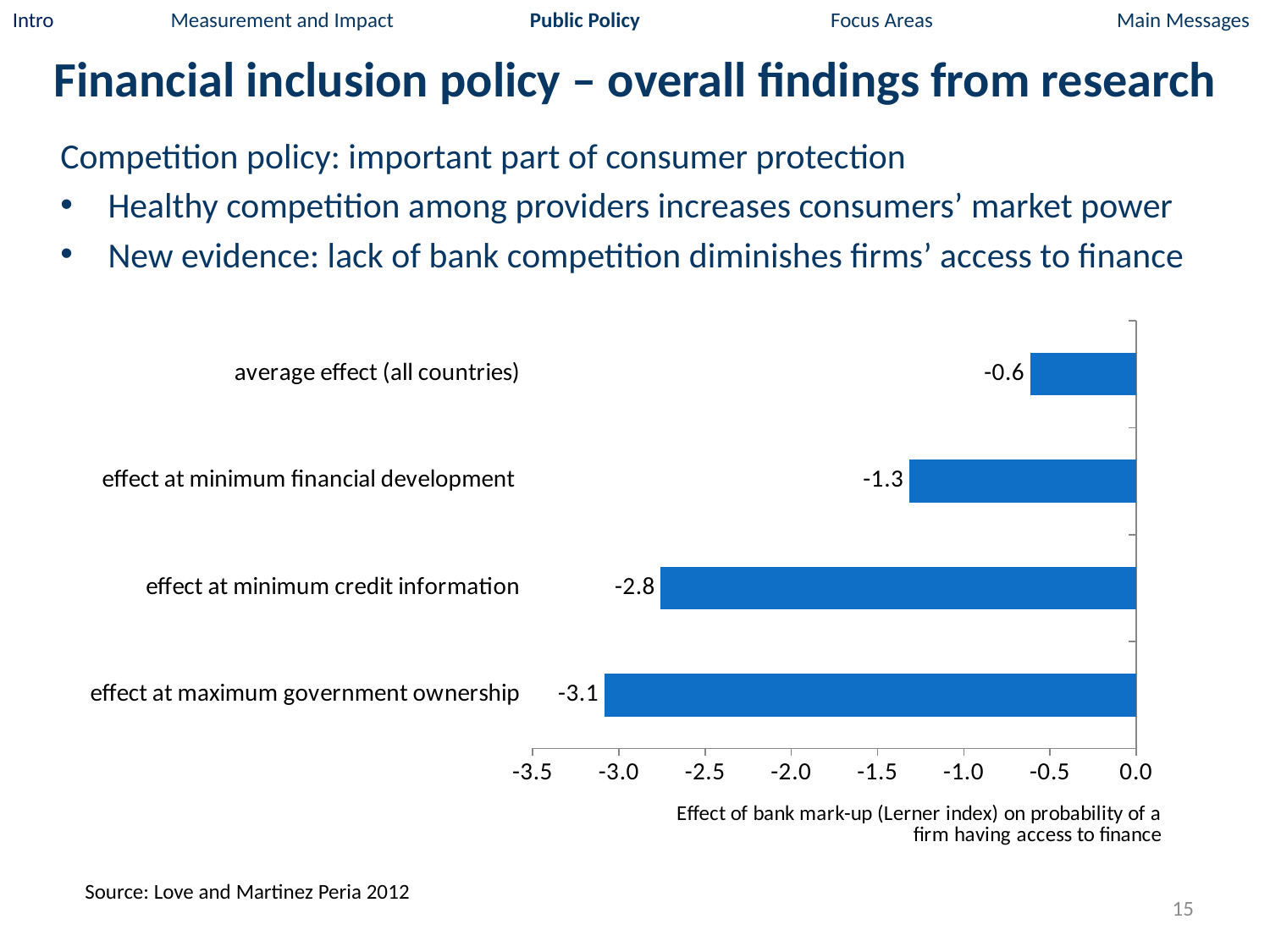
What is the value for 'average effect (all countries)'? -0.6 Which is more negative: 'effect at minimum credit information' or 'effect at minimum financial development'? effect at minimum credit information What is the value for 'effect at minimum credit information'? -2.8 What kind of chart is shown on the slide? bar chart Which category has the highest (least negative) value? average effect (all countries) What is the value for 'effect at minimum financial development'? -1.3 What is the difference between the values for 'effect at maximum government ownership' and 'effect at minimum credit information'? 0.3 What is the value for 'effect at maximum government ownership'? -3.1 What is the difference between the values for 'effect at minimum financial development' and 'average effect (all countries)'? 0.7 How many categories are shown in the chart? 4 What is the label on the horizontal axis of the chart? Effect of bank mark-up (Lerner index) on probability of a firm having access to finance Which category has the lowest (most negative) value? effect at maximum government ownership